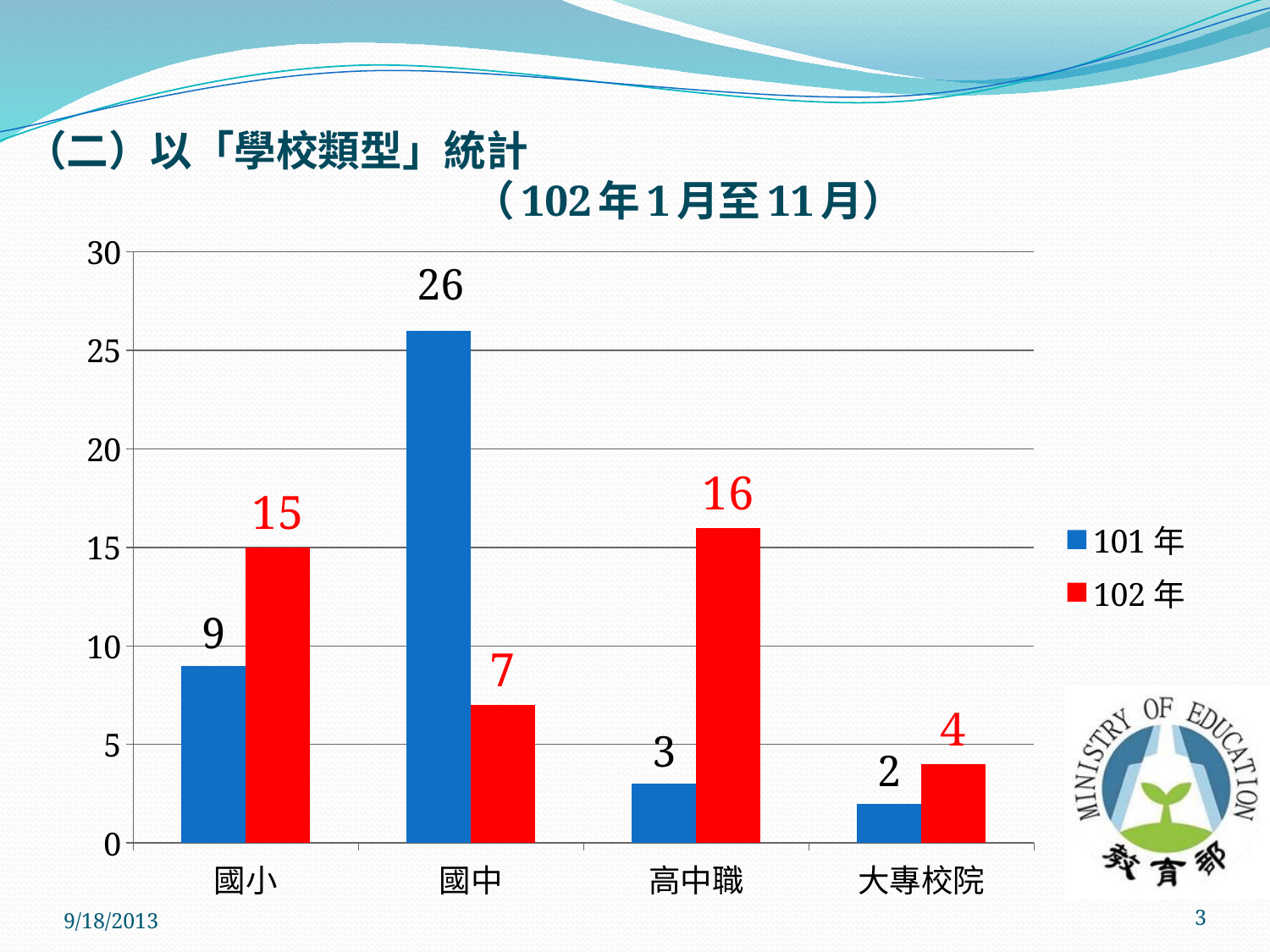
What is the value for 大專校院 in the 101 年 series? 2 What is the difference between the 102 年 and 101 年 values for 高中職? 13 Which is larger for 國小: the 101 年 value or the 102 年 value? 102 年 What is the value for 國中 in the 101 年 series? 26 How many categories are shown on the x axis? 4 What is the difference between the 101 年 and 102 年 values for 國中? 19 What is the value for 高中職 in the 102 年 series? 16 How many series does the legend list? 2 Which category has the lowest value in the 102 年 series? 大專校院 Which category has the highest value in the 101 年 series? 國中 What kind of chart is shown on the slide? bar chart What colour represents the 102 年 series? red